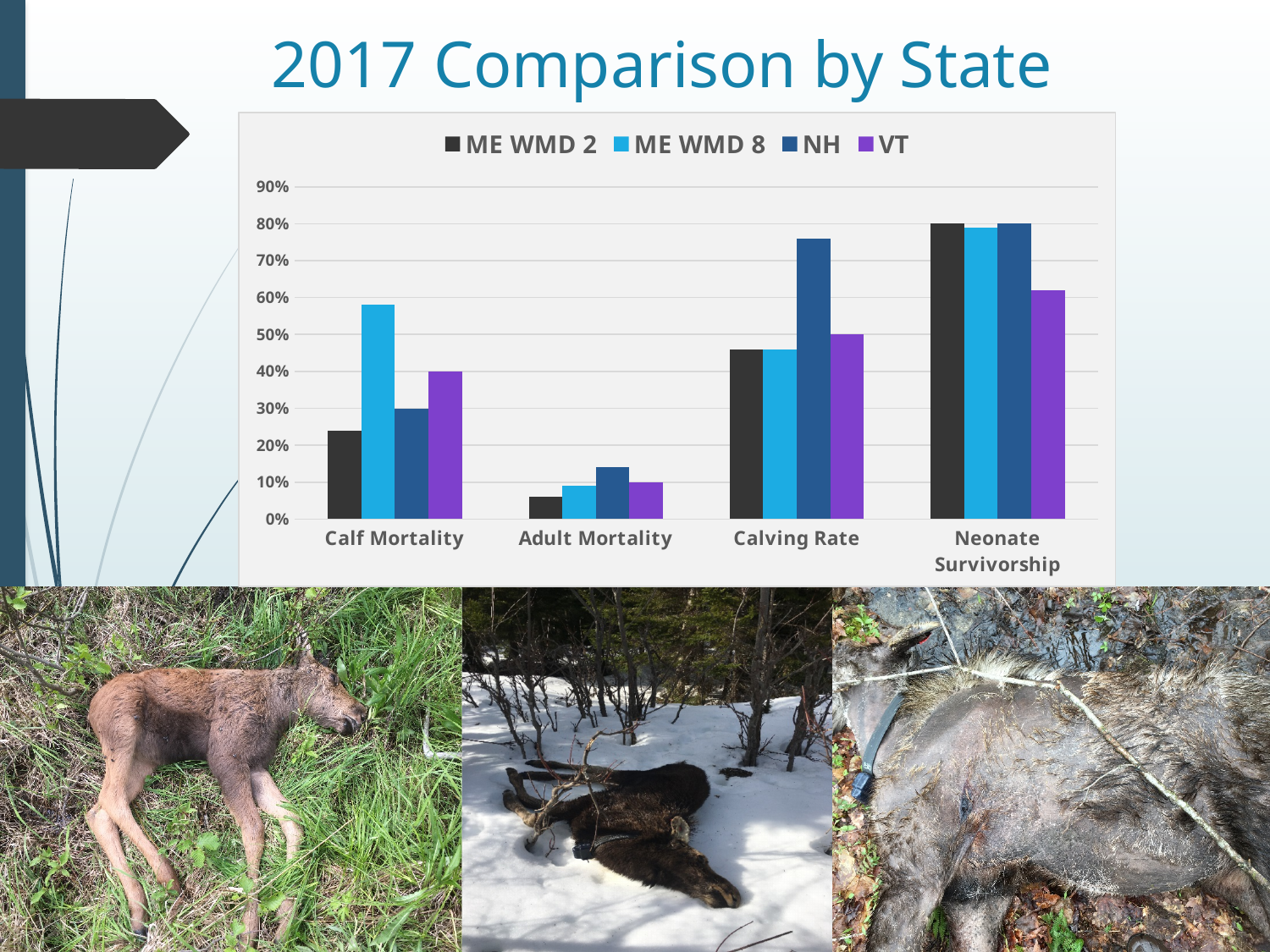
What kind of chart is shown on the slide? bar chart Is the Adult Mortality value for NH greater or less than 20%? less Is the Calving Rate value for NH greater or less than 70%? greater Which series has the highest Calving Rate? NH Which series has the highest Calf Mortality? ME WMD 8 Which series has the lowest Neonate Survivorship? VT Which is larger: the Calf Mortality for VT or the Calf Mortality for NH? VT What is the title of the slide containing the chart? 2017 Comparison by State Is the Calf Mortality value for ME WMD 8 greater or less than 50%? greater How many categories are shown on the x axis? 4 How many series does the legend list? 4 Which series has the lowest Calf Mortality? ME WMD 2